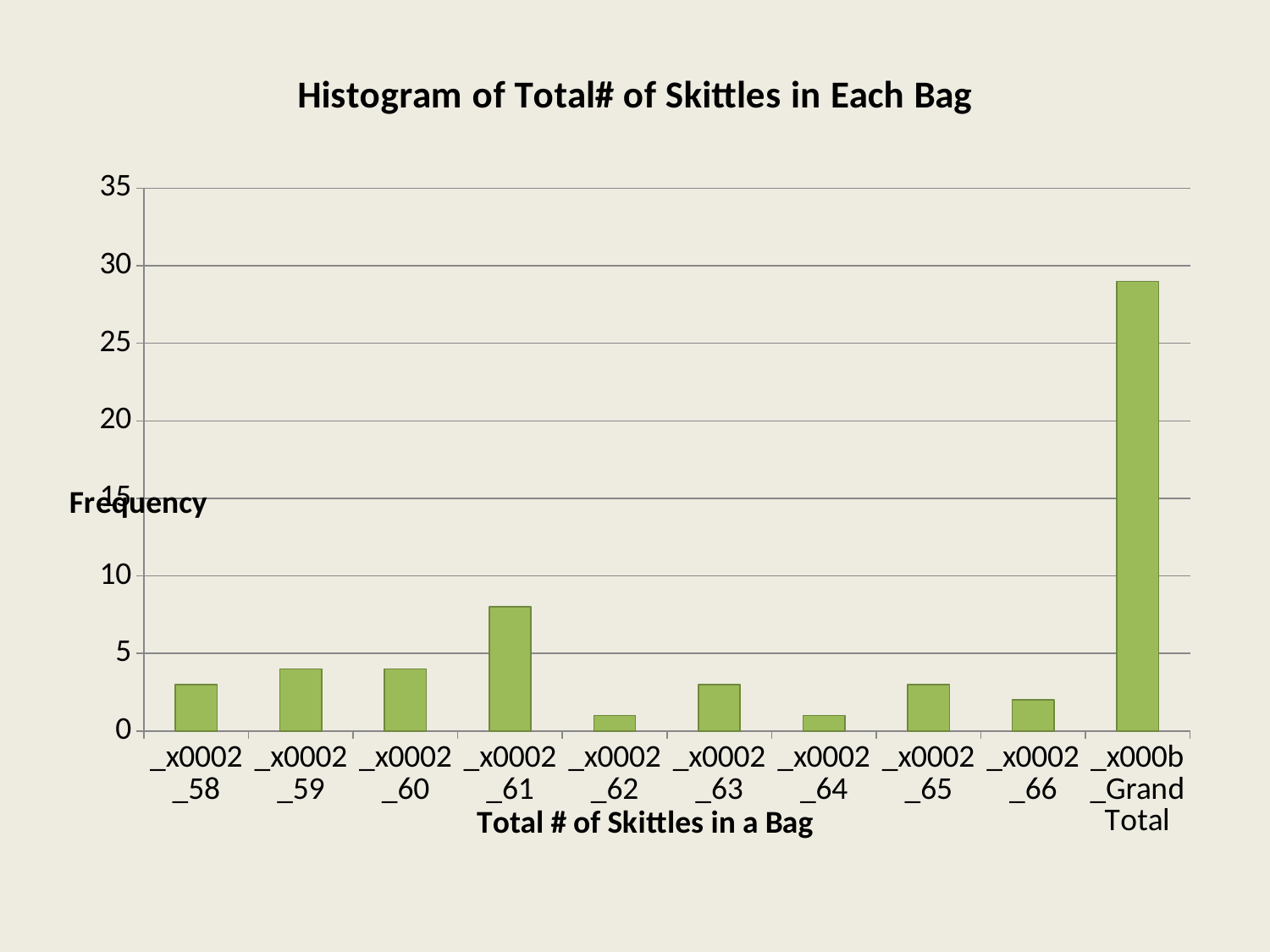
Is the frequency for the Grand Total bar greater or less than 25? greater Excluding the Grand Total bar, which bag total has the highest frequency? 61 What is the label of the vertical axis? Frequency What kind of chart is shown on the slide? bar chart Is the frequency for 62 Skittles greater or less than 5? less Which category has the highest bar? Grand Total How many bars (categories) are plotted on the chart? 10 Which has the higher frequency, 61 Skittles or 59 Skittles? 61 What is the title of the chart? Histogram of Total# of Skittles in Each Bag Which has the higher frequency, 65 Skittles or 64 Skittles? 65 Is the frequency for 61 Skittles greater or less than 5? greater